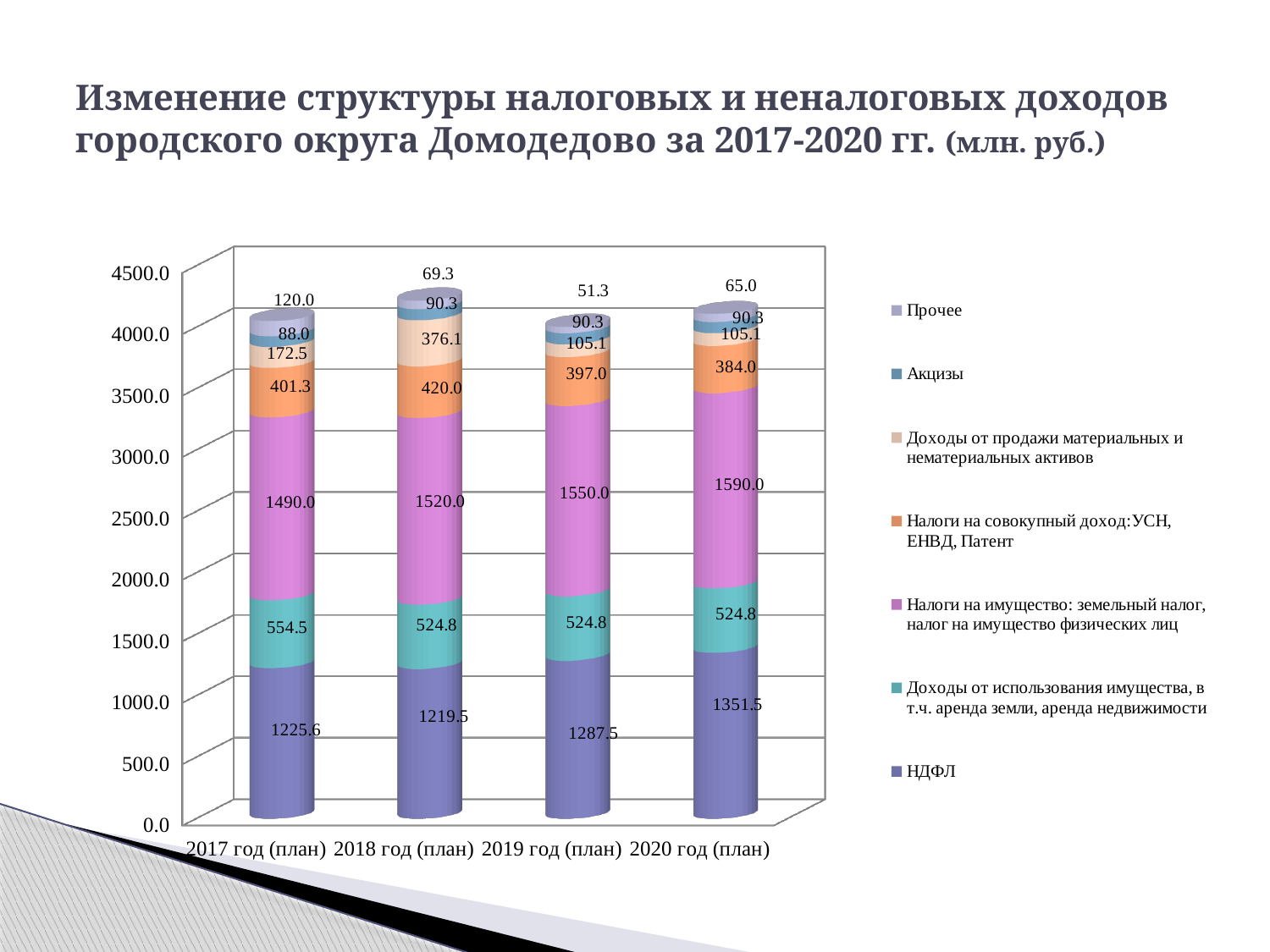
Which is larger: Доходы от использования имущества for 2017 год (план) or for 2018 год (план)? 2017 год (план) In which year is the Прочее value the lowest? 2019 год (план) What is the value of Доходы от продажи материальных и нематериальных активов for 2018 год (план)? 376.1 Do the Налоги на имущество values rise or fall from 2017 to 2020? Rise How many series does the legend list? 7 How many years (categories) are shown on the x axis? 4 In which year is the НДФЛ value the highest? 2020 год (план) What is the value of НДФЛ for 2017 год (план)? 1225.6 What kind of chart is shown on the slide? Stacked bar chart What is the value of Налоги на имущество: земельный налог, налог на имущество физических лиц for 2020 год (план)? 1590.0 What is the difference between the Налоги на совокупный доход:УСН, ЕНВД, Патент values for 2018 год (план) and 2017 год (план)? 18.7 What is the total of the stacked bar for 2019 год (план)? 4006.0